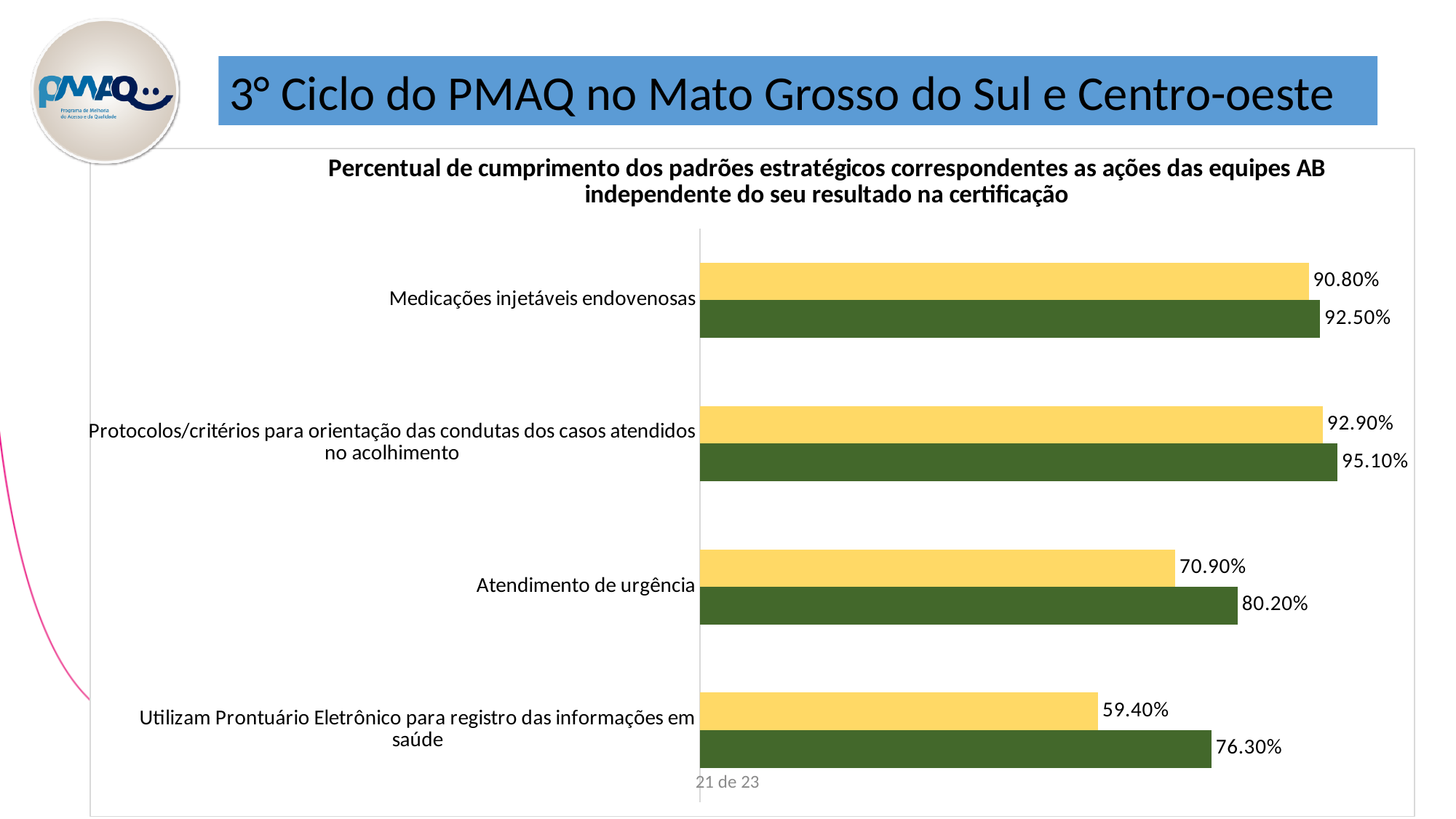
What kind of chart is shown on the slide? bar chart What is the difference between the green and yellow bar values for Atendimento de urgência? 9.30% Which category has the highest green bar value? Protocolos/critérios para orientação das condutas dos casos atendidos no acolhimento What is the value of the yellow bar for Utilizam Prontuário Eletrônico para registro das informações em saúde? 59.40% What is the value of the yellow bar for Atendimento de urgência? 70.90% Which is larger for Medicações injetáveis endovenosas: the yellow bar or the green bar? the green bar Which category has the lowest yellow bar value? Utilizam Prontuário Eletrônico para registro das informações em saúde What is the difference between the green and yellow bar values for Utilizam Prontuário Eletrônico para registro das informações em saúde? 16.90% How many categories are shown on the chart? 4 What is the value of the green bar for Protocolos/critérios para orientação das condutas dos casos atendidos no acolhimento? 95.10% What is the title of the chart? Percentual de cumprimento dos padrões estratégicos correspondentes as ações das equipes AB independente do seu resultado na certificação What is the value of the green bar for Medicações injetáveis endovenosas? 92.50%